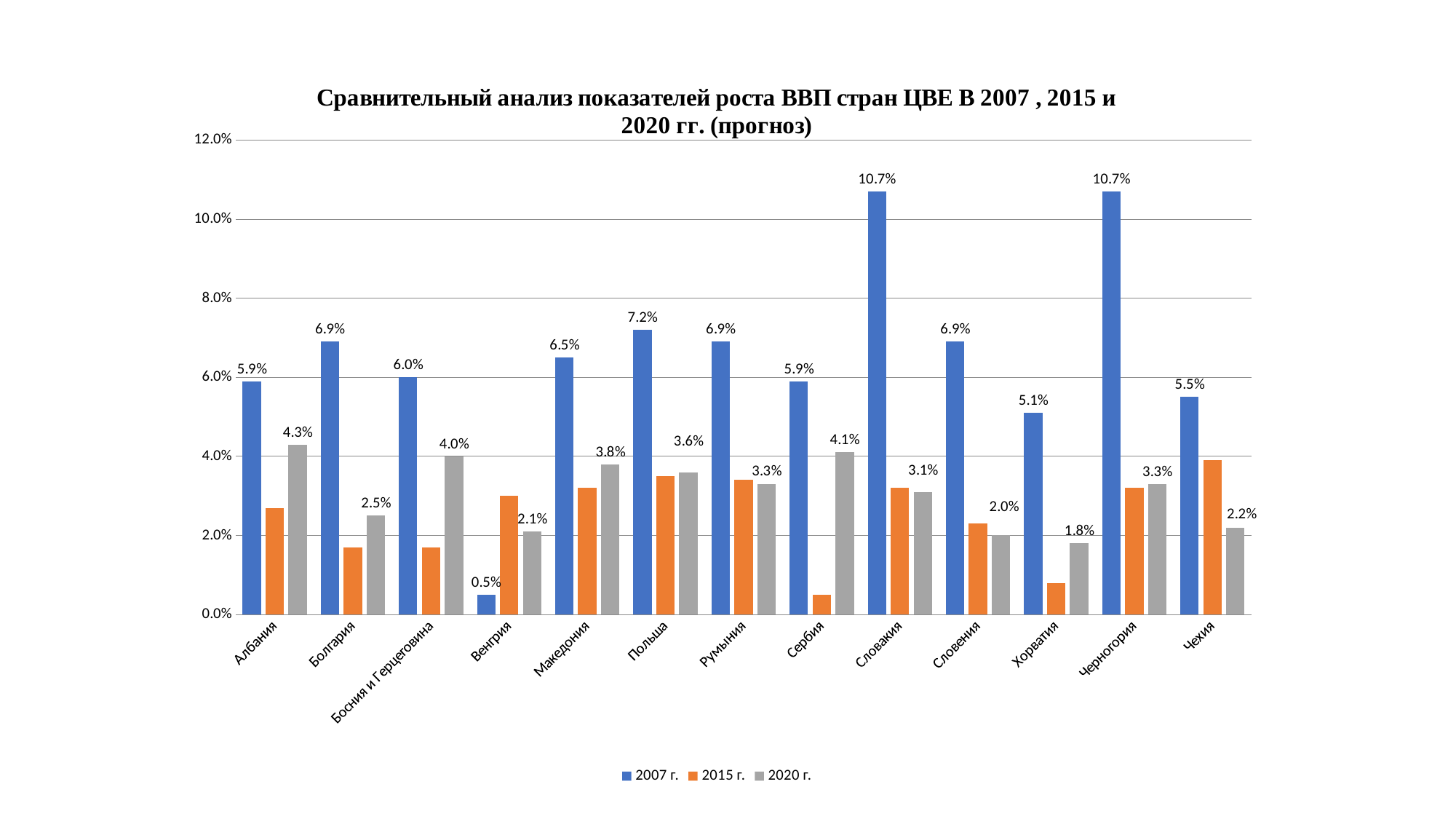
How many series does the legend list? 3 How many countries are shown on the x axis? 13 What is the difference between the 2007 г. and 2020 г. values for Словакия? 7.6 percentage points What kind of chart is shown on the slide? Bar chart Which country has the lowest value in the 2020 г. series? Хорватия What is the GDP growth value for Польша in the 2007 г. series? 7.2% In the 2020 г. series, which is larger: Македония or Польша? Македония Is the 2015 г. value for Хорватия greater or less than 2.0%? less Which country has the lowest value in the 2007 г. series? Венгрия Is the 2015 г. value for Венгрия greater or less than 2.0%? greater What is the value for Албания in the 2020 г. series? 4.3% Which two countries share the highest value in the 2007 г. series? Словакия and Черногория